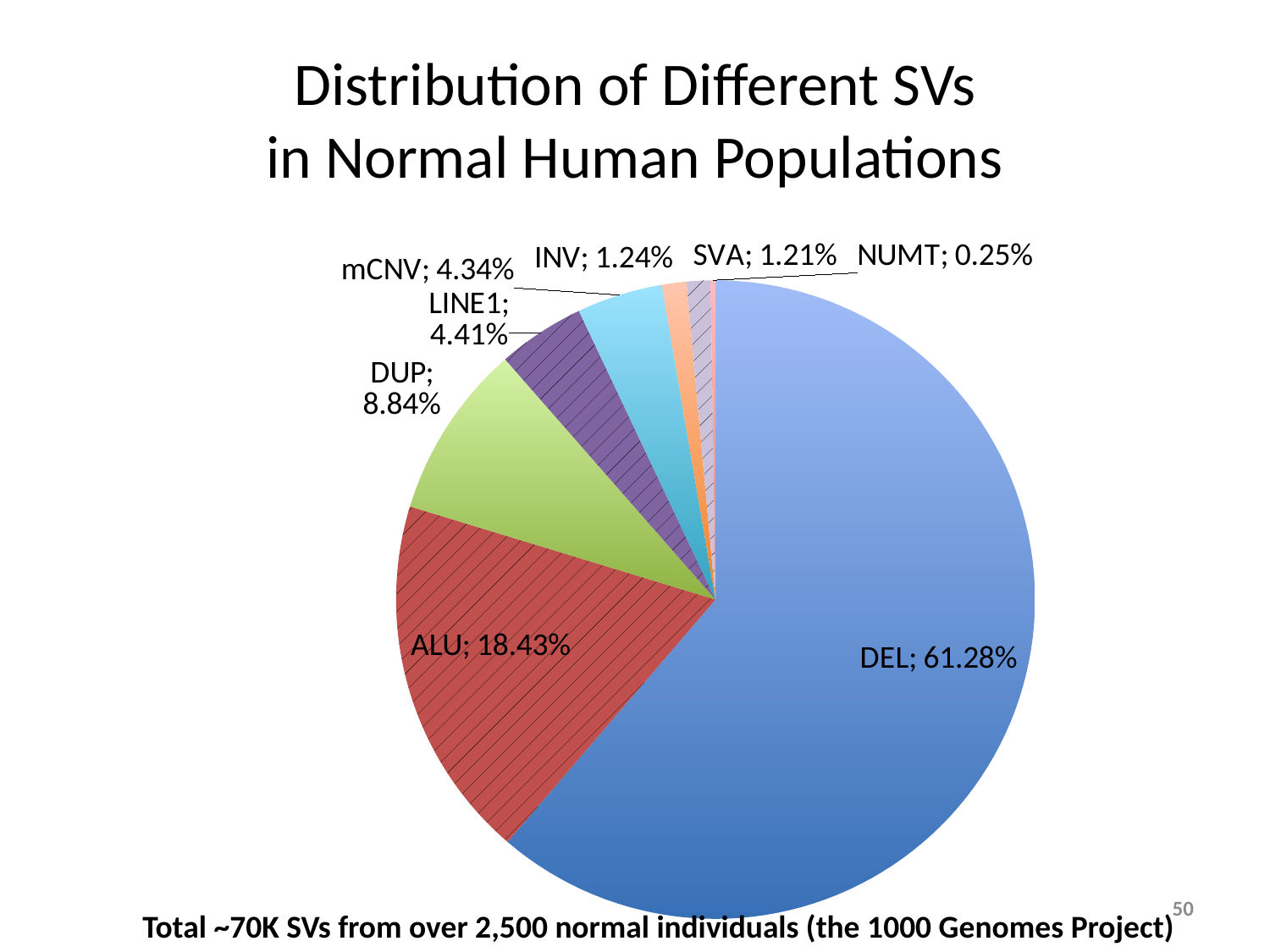
What is the difference between the DEL share and the ALU share? 42.85% What percentage of SVs are DEL? 61.28% Which is larger, the share for DUP or the share for INV? DUP What is the share shown for NUMT? 0.25% What is the share shown for DUP? 8.84% Which SV type has the smallest slice of the pie? NUMT Which SV type has the largest slice of the pie? DEL What kind of chart is shown on the slide? pie chart What is the title of the chart? Distribution of Different SVs in Normal Human Populations What is the share shown for mCNV? 4.34% What percentage of SVs are ALU? 18.43% How many SV types (slices) are shown in the pie chart? 8